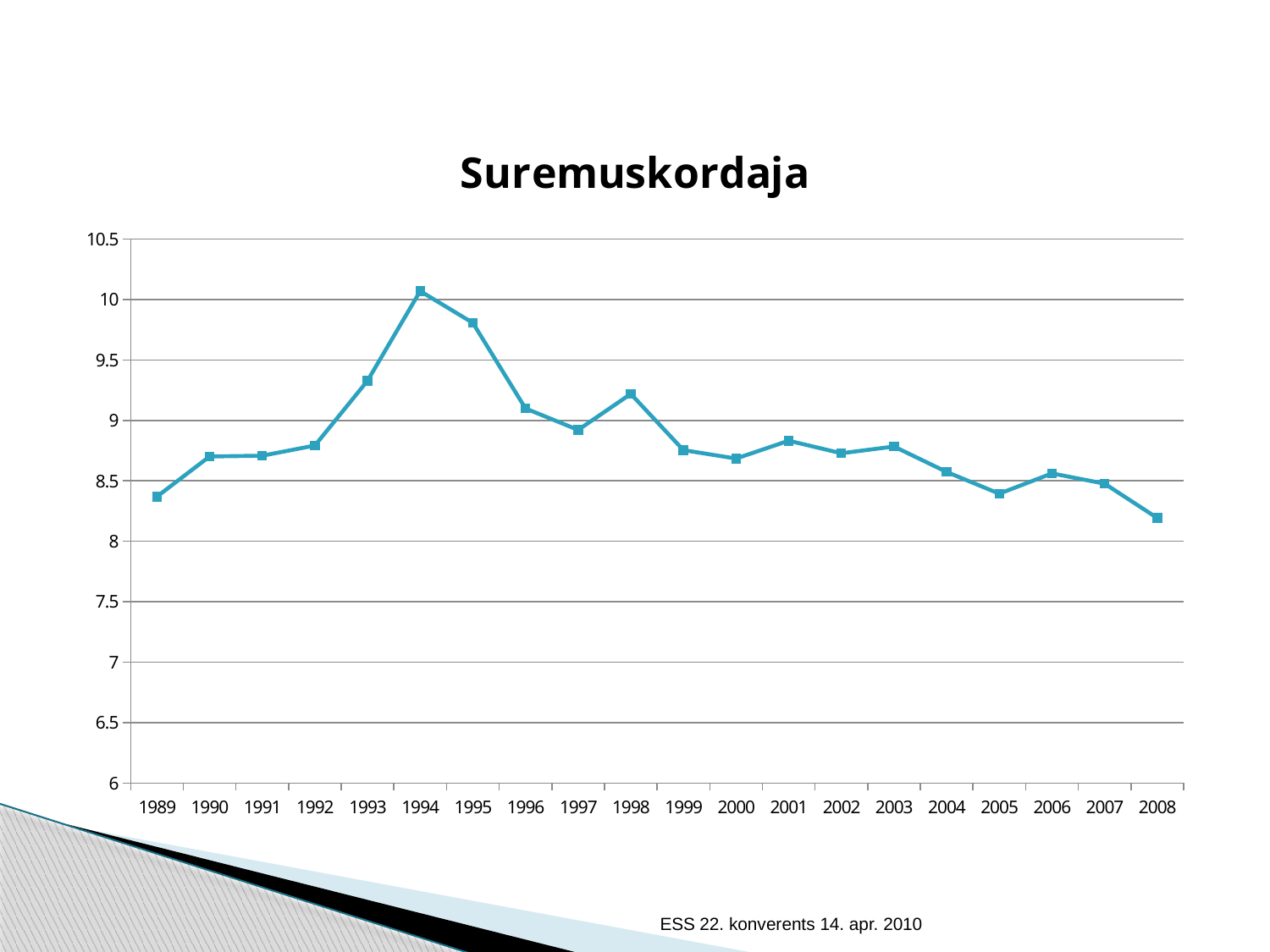
What is the title of the chart? Suremuskordaja Which year has the larger value, 1997 or 1998? 1998 Do the values generally rise or fall from 1994 to 2008? fall In which year is the value highest? 1994 Is the value for 1994 greater or less than 10? greater How many years are plotted on the x axis? 20 Is the value for 1989 greater or less than 8.5? less Is the value for 1993 greater or less than 9.5? less What kind of chart is shown on the slide? line chart In which year is the value lowest? 2008 Which year has the larger value, 1994 or 1995? 1994